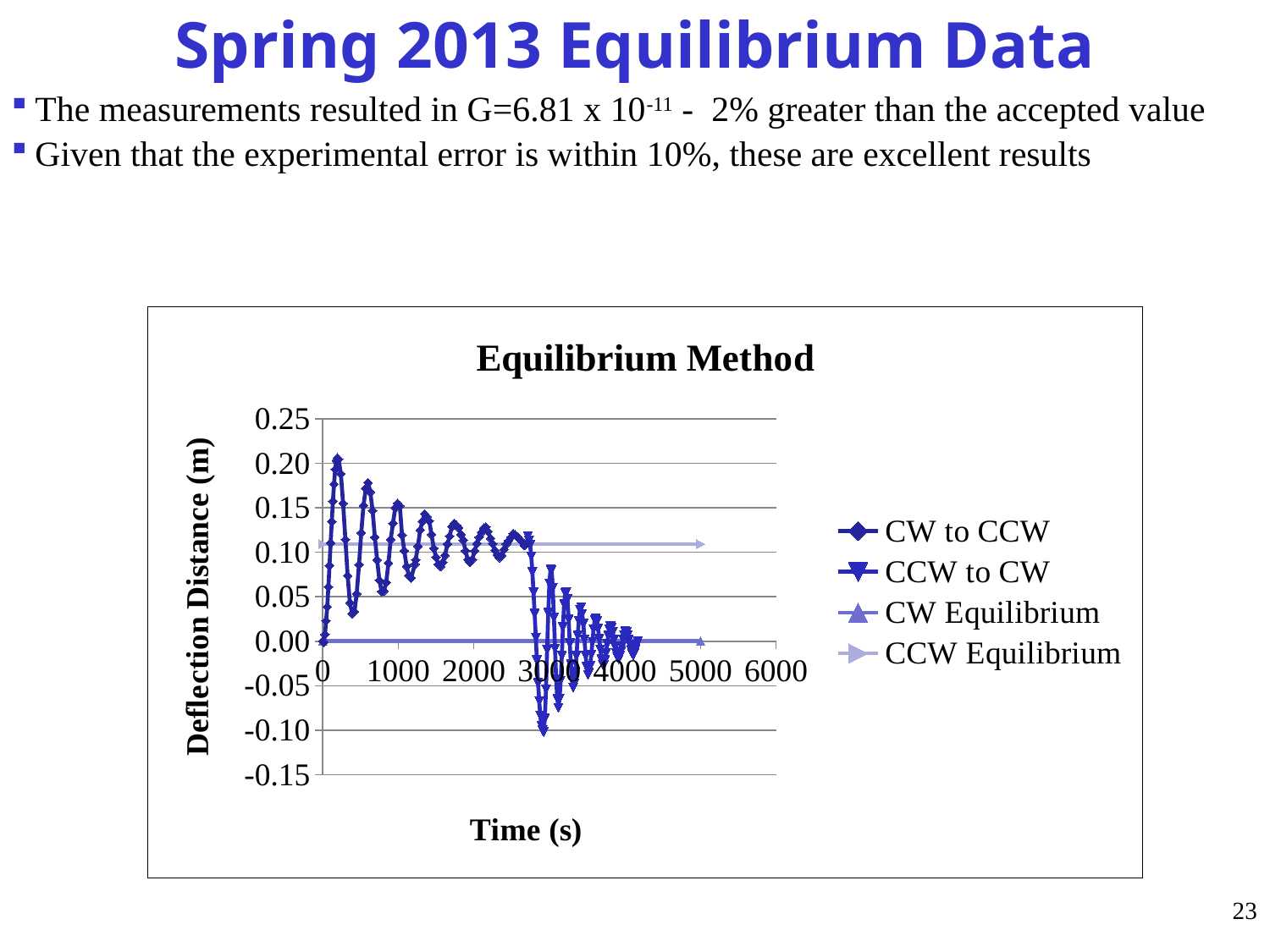
Which is higher on the chart, the CW Equilibrium line or the CCW Equilibrium line? CCW Equilibrium Is the lowest value of the CCW to CW series greater or less than -0.05? less Which series reaches the highest deflection distance on the chart? CW to CCW What type of chart is shown on the slide? line chart Is the peak value of the CW to CCW series greater or less than 0.15? greater How many series does the chart legend list? 4 Do the peaks of the CW to CCW series rise or fall as time increases? fall Which series reaches the lowest deflection distance on the chart? CCW to CW Is the CW Equilibrium line greater or less than 0.05? less What is the title of the chart on the slide? Equilibrium Method What is the label of the x axis of the chart? Time (s)